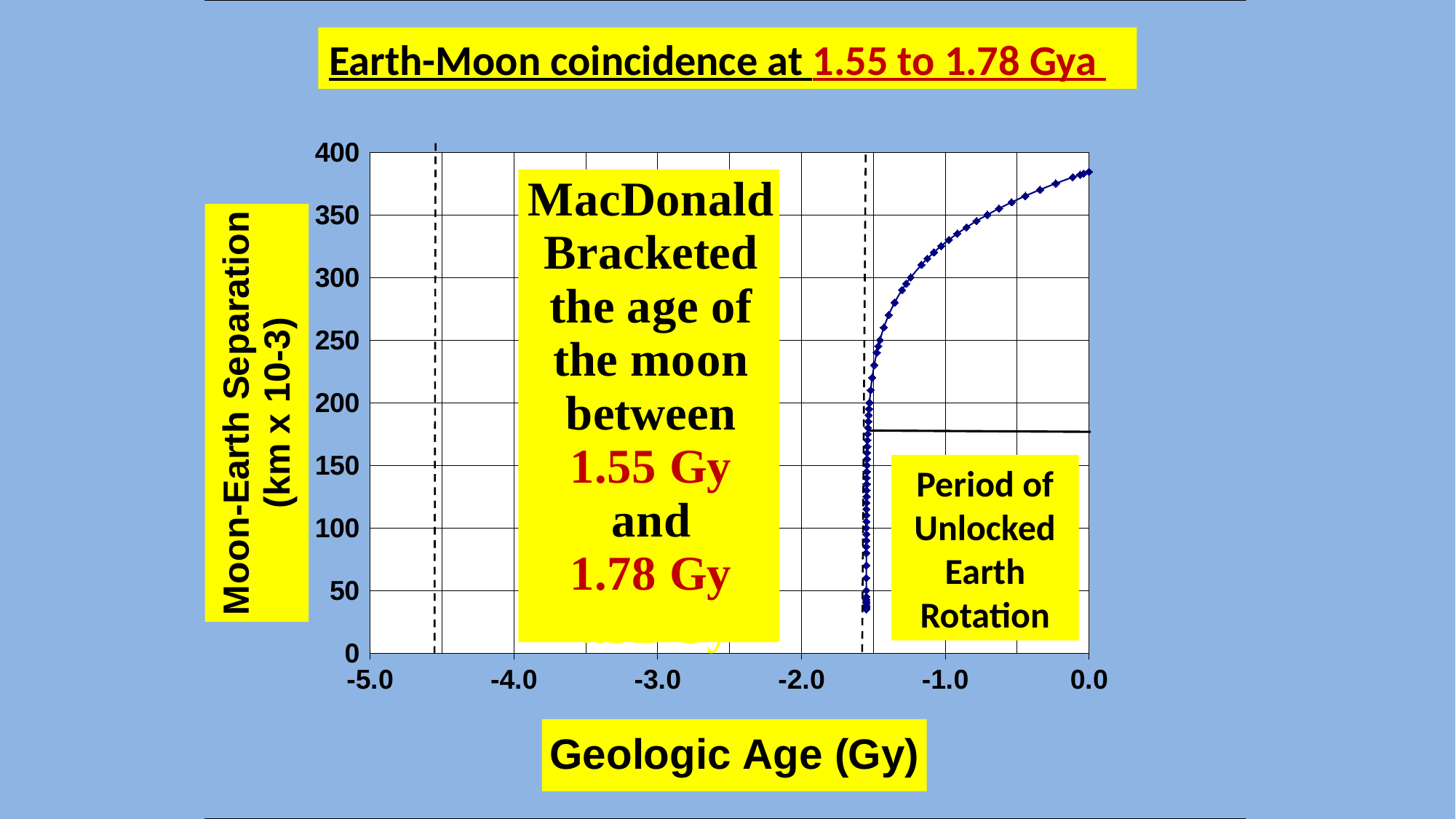
Which geologic age has the larger Moon-Earth separation, -1.0 or 0.0? 0.0 What is the title of the x axis? Geologic Age (Gy) Is the Moon-Earth separation at a geologic age of -1.0 greater or less than 300? greater At which labelled x-axis value does the plotted curve reach its highest Moon-Earth separation? 0.0 How many labelled tick values are there on the x axis? 6 What is the title of the y axis? Moon-Earth Separation (km x 10-3) Is the Moon-Earth separation at a geologic age of 0.0 greater or less than 350? greater What kind of chart is shown on the slide? line chart Is the Moon-Earth separation at a geologic age of -1.0 greater or less than 350? less What is the highest value labelled on the y axis? 400 Does the Moon-Earth separation rise or fall as the geologic age moves from -1.5 toward 0.0 on the x axis? rise